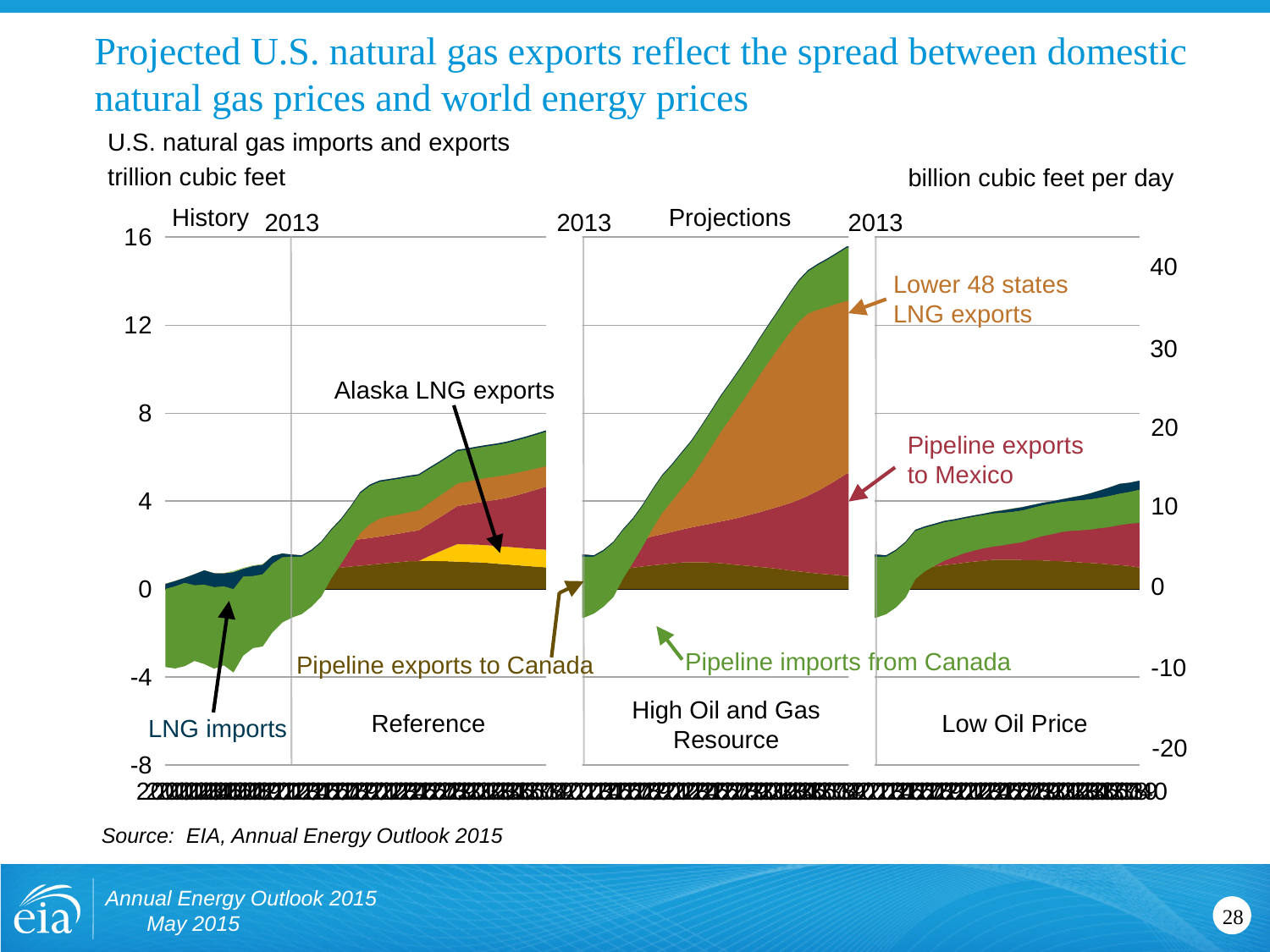
What is the title of the chart? U.S. natural gas imports and exports What kind of chart is shown on the slide? area chart In the Low Oil Price panel, is the total net exports at the end of the projection greater or less than 8 trillion cubic feet? less Which scenario has larger total net exports at the end of the projection: Reference or Low Oil Price? Reference In the High Oil and Gas Resource panel, is the total net exports at the end of the projection greater or less than 12 trillion cubic feet? greater In the Reference panel, do total net exports rise or fall over the projection period? rise Which scenario reaches the highest total net exports by the end of the projection period? High Oil and Gas Resource Which scenario has the lowest total net exports at the end of the projection period? Low Oil Price How many scenario panels does the chart show? 3 How many labeled components (series) are identified on the chart? 6 In the Reference panel, is the total net exports at the end of the projection greater or less than 4 trillion cubic feet? greater Which scenario panel includes the Alaska LNG exports component? Reference